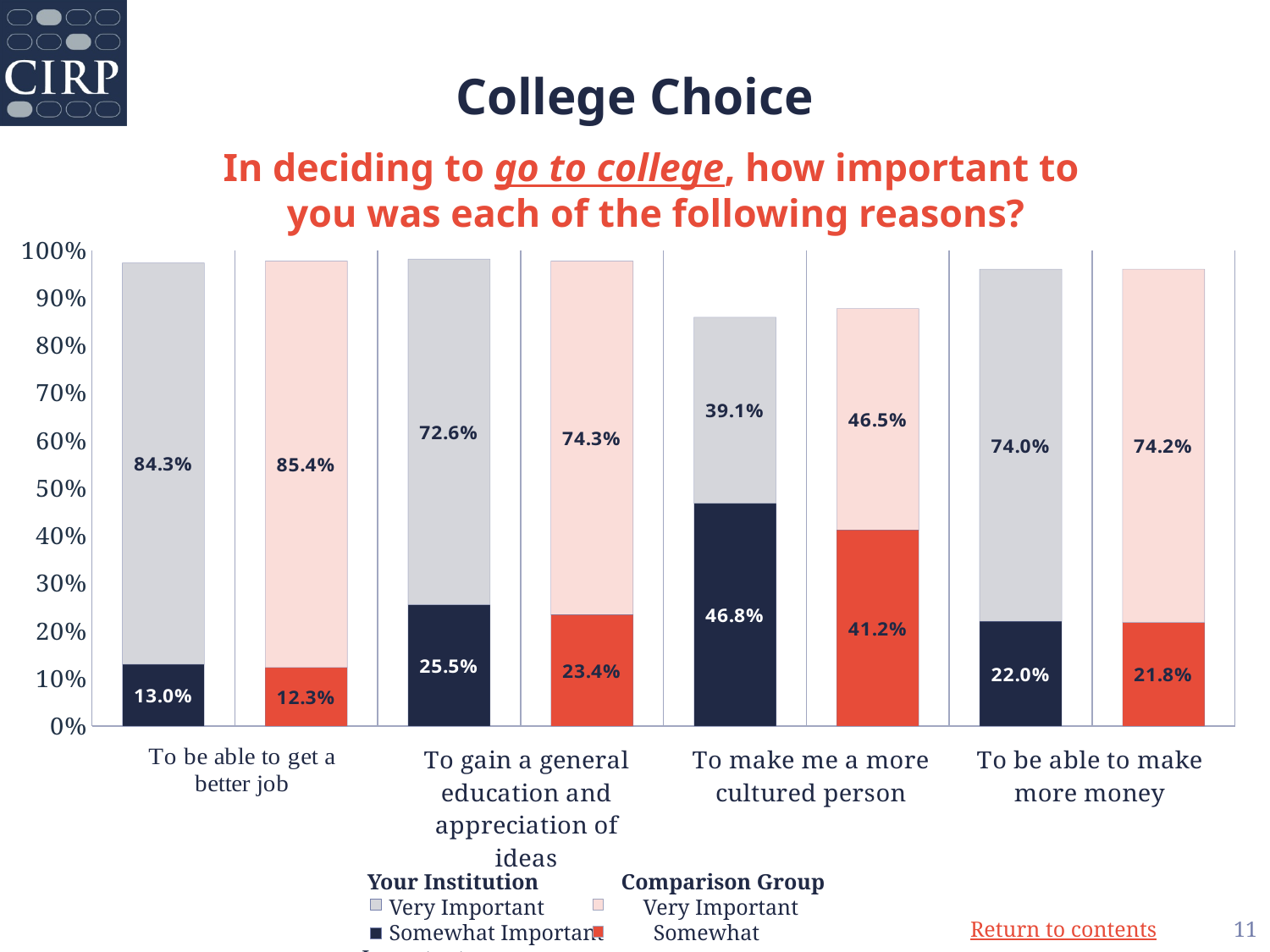
What is the combined Very Important and Somewhat Important total for Your Institution on "To be able to get a better job"? 97.3% What is the difference between the Comparison Group and Your Institution Very Important percentages for "To make me a more cultured person"? 7.4% Which reason has the lowest Very Important percentage for Your Institution? To make me a more cultured person How many series does the chart legend list? 4 For "To gain a general education and appreciation of ideas", which group has the larger Somewhat Important percentage, Your Institution or the Comparison Group? Your Institution What percentage of Your Institution students rated "To be able to get a better job" as Very Important? 84.3% Which reason has the highest Very Important percentage for the Comparison Group? To be able to get a better job What percentage of the Comparison Group rated "To make me a more cultured person" as Somewhat Important? 41.2% What type of chart is shown on the slide? Stacked bar chart What percentage of Your Institution students rated "To be able to make more money" as Somewhat Important? 22.0% How many reasons (categories) are shown on the x axis of the chart? 4 What is the combined Very Important and Somewhat Important total for the Comparison Group on "To make me a more cultured person"? 87.7%